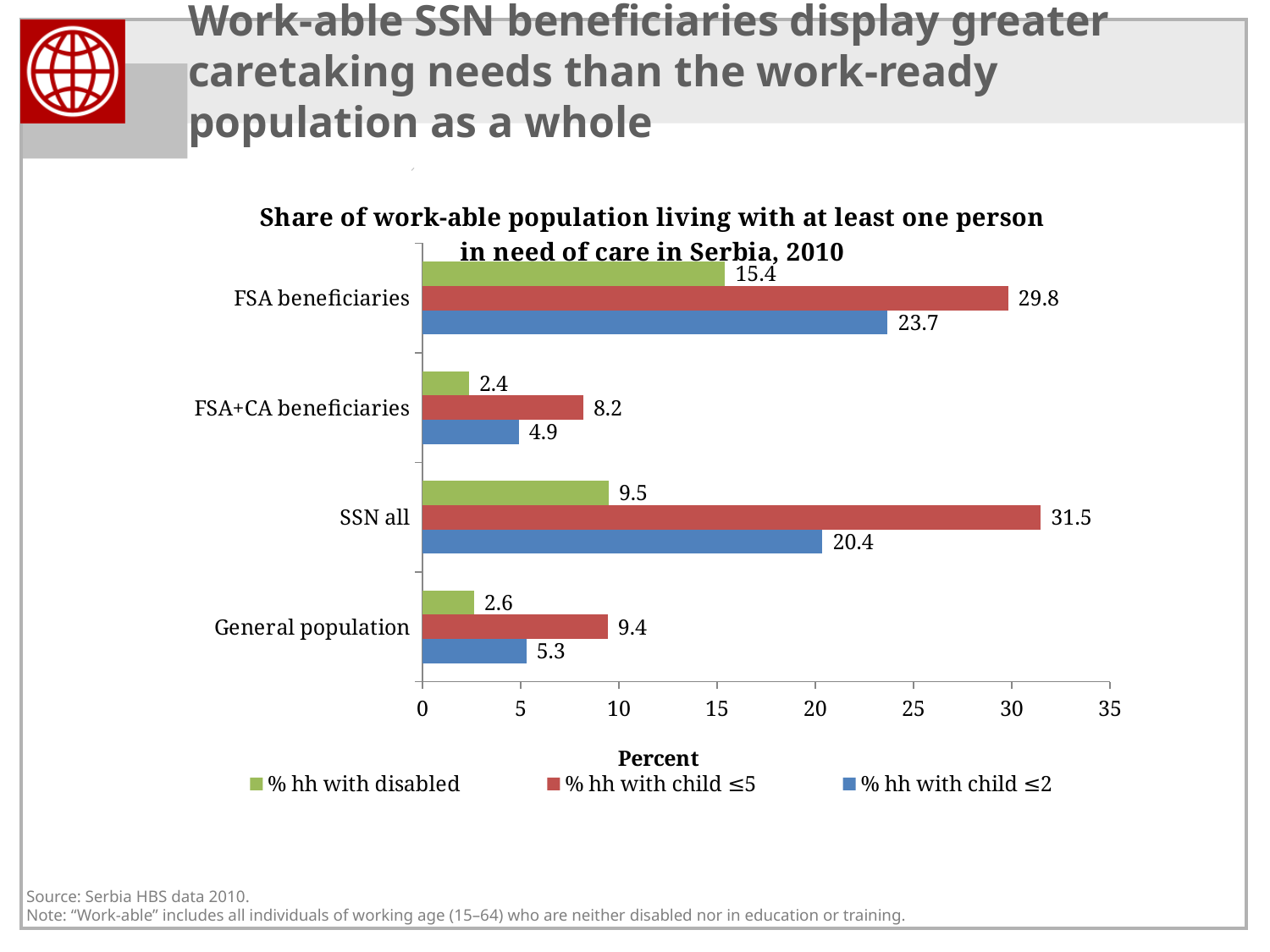
Which is larger: '% hh with child ≤5' for FSA beneficiaries or for SSN all? SSN all What is the value for '% hh with child ≤5' for SSN all? 31.5 Which category has the lowest value for '% hh with disabled'? FSA+CA beneficiaries What kind of chart is shown on the slide? Bar chart What is the label of the x axis? Percent Which category has the highest value for '% hh with child ≤5'? SSN all What is the value for '% hh with disabled' for FSA beneficiaries? 15.4 How many series does the legend list? 3 What is the value for '% hh with child ≤2' for the General population? 5.3 What is the difference between the '% hh with child ≤2' values for FSA beneficiaries and FSA+CA beneficiaries? 18.8 How many categories are shown on the y axis? 4 Is the value for '% hh with child ≤2' for SSN all greater or less than 15? greater